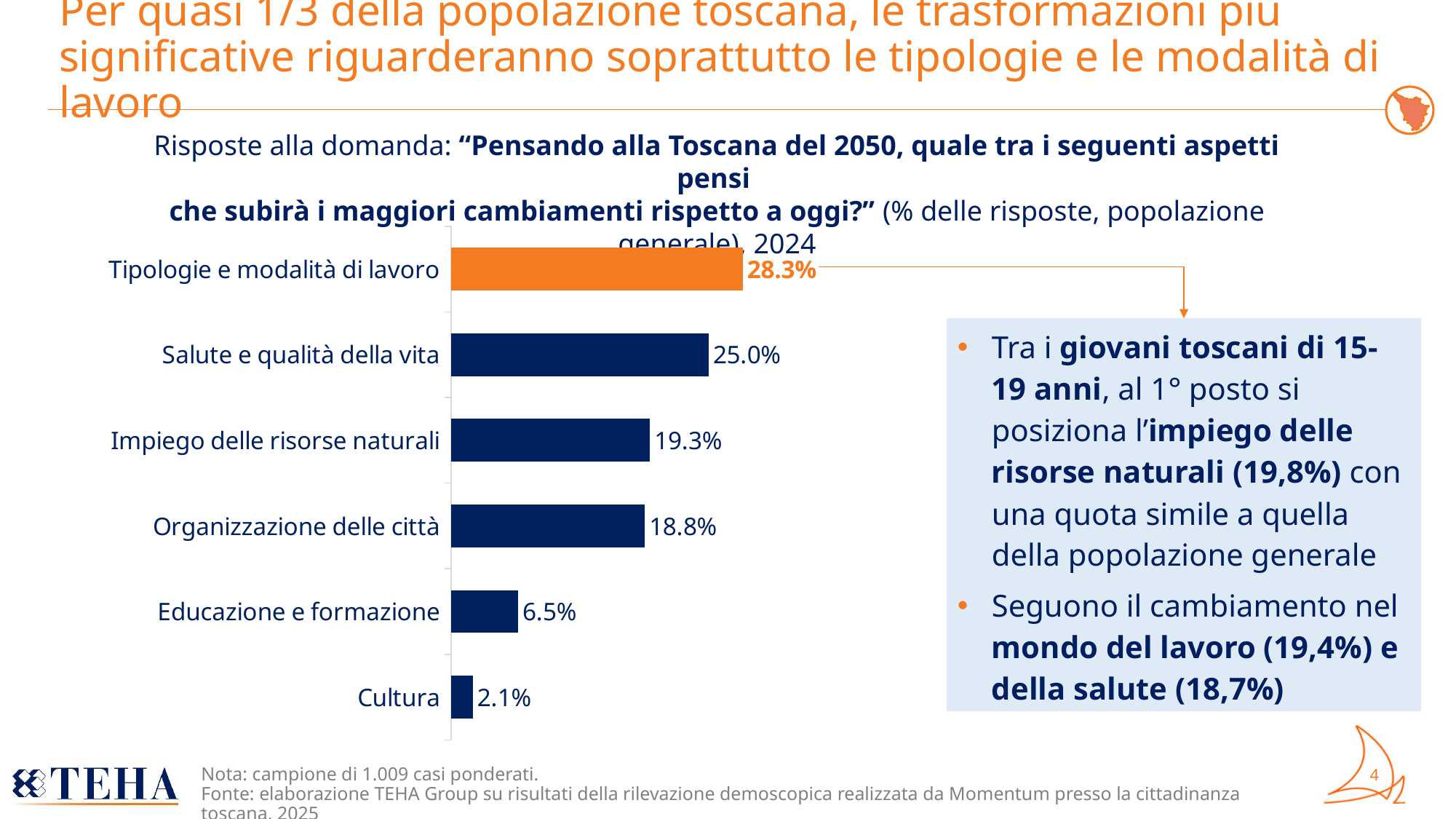
What is the value for "Salute e qualità della vita"? 25.0% What is the value for "Impiego delle risorse naturali"? 19.3% Which category has the highest value? Tipologie e modalità di lavoro What is the value for "Cultura"? 2.1% Which category has the lowest value? Cultura Which bar is highlighted in orange? Tipologie e modalità di lavoro How many categories are shown in the chart? 6 What kind of chart is shown on the slide? Bar chart What is the value for "Organizzazione delle città"? 18.8% What is the value for "Tipologie e modalità di lavoro"? 28.3% Which is larger: "Educazione e formazione" or "Cultura"? Educazione e formazione What is the difference between "Tipologie e modalità di lavoro" and "Salute e qualità della vita"? 3.3%